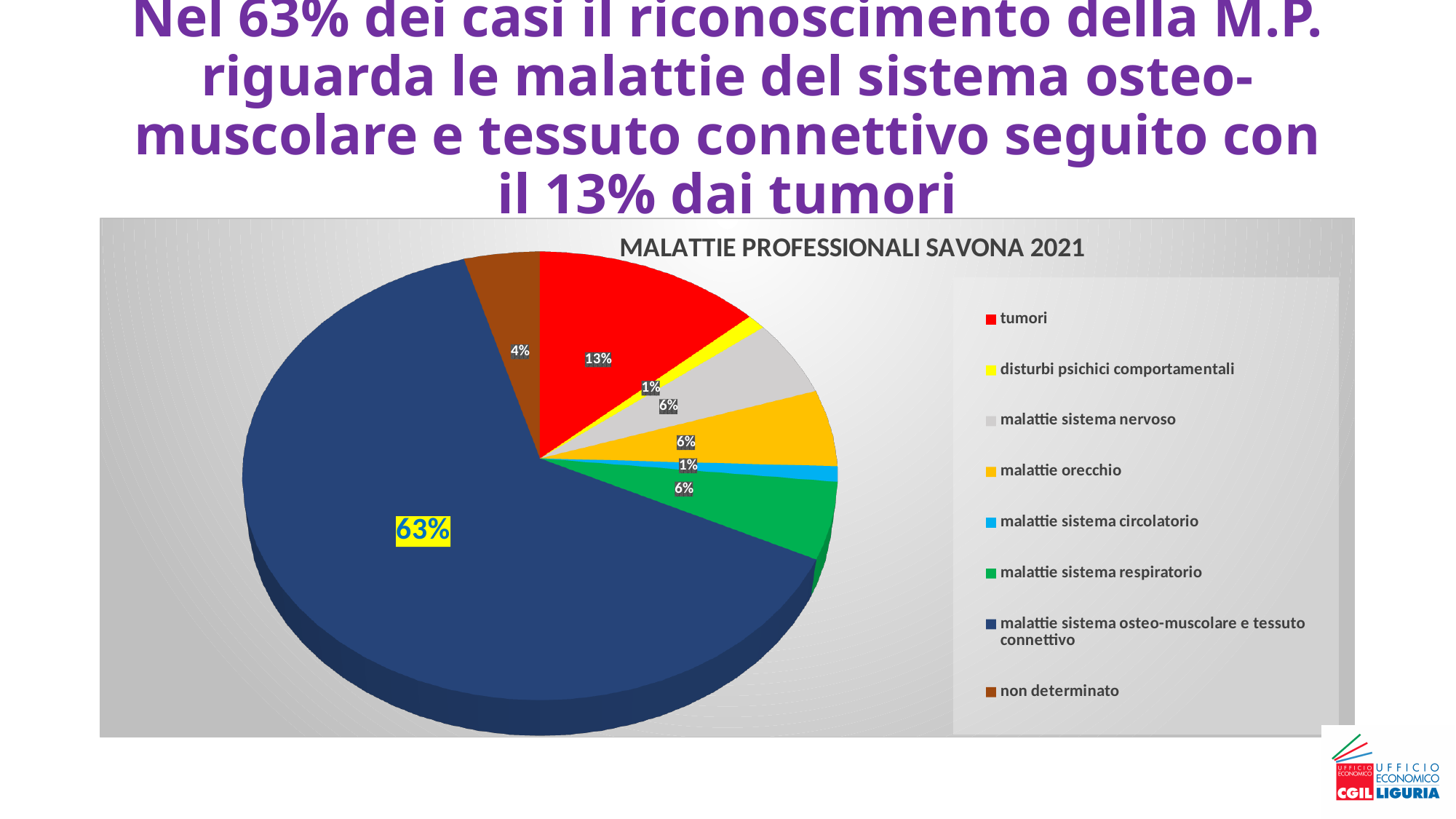
Which slice is larger: tumori or non determinato? tumori What share of the pie is labelled for non determinato? 4% What share of the pie is labelled for malattie sistema osteo-muscolare e tessuto connettivo? 63% What share of the pie is labelled for tumori? 13% What share of the pie is labelled for disturbi psichici comportamentali? 1% What is the difference in percentage points between the slice for malattie sistema osteo-muscolare e tessuto connettivo and the slice for tumori? 50 What is the title of the chart? MALATTIE PROFESSIONALI SAVONA 2021 Which category has the largest slice of the pie? malattie sistema osteo-muscolare e tessuto connettivo What share of the pie is labelled for malattie sistema respiratorio? 6% What colour is the slice for malattie orecchio? Yellow-orange How many categories does the legend list? 8 What type of chart is shown on the slide? Pie chart